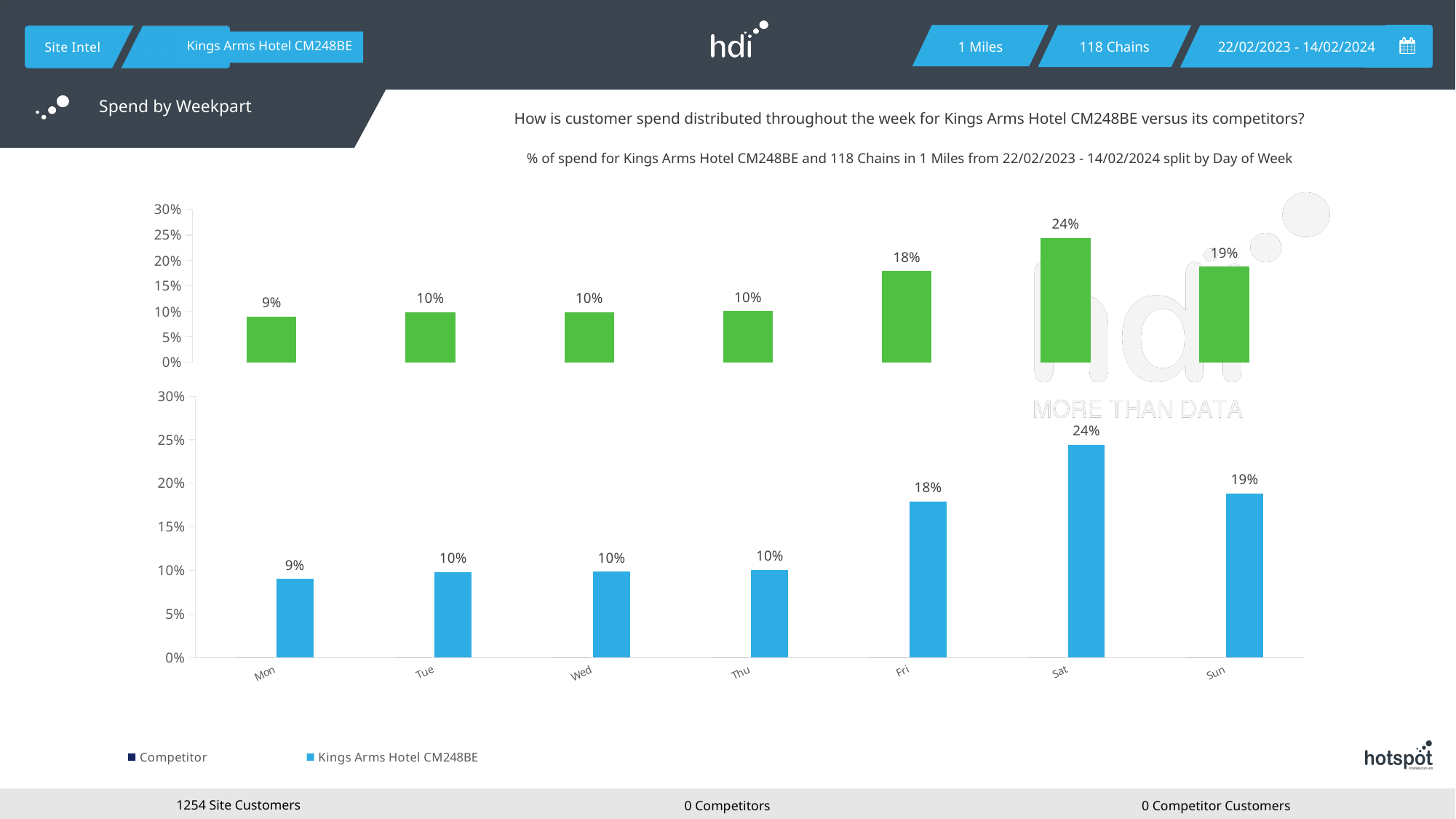
In the bottom chart, what is the difference between the values for Sat and Sun? 5% How many series does the legend list? 2 In the bottom chart, what is the value for Sat? 24% In the top chart, what is the value of the tallest bar? 24% How many days are shown on the x axis of the bottom chart? 7 In the bottom chart, is the value for Thu greater or less than 15%? less In the bottom chart, what is the value for Fri? 18% In the bottom chart, which day has the lowest value? Mon In the bottom chart, which day has the highest value? Sat What kind of chart is the bottom chart? bar chart In the bottom chart, which is larger, the value for Fri or the value for Sun? Sun In the bottom chart, what is the value for Mon? 9%